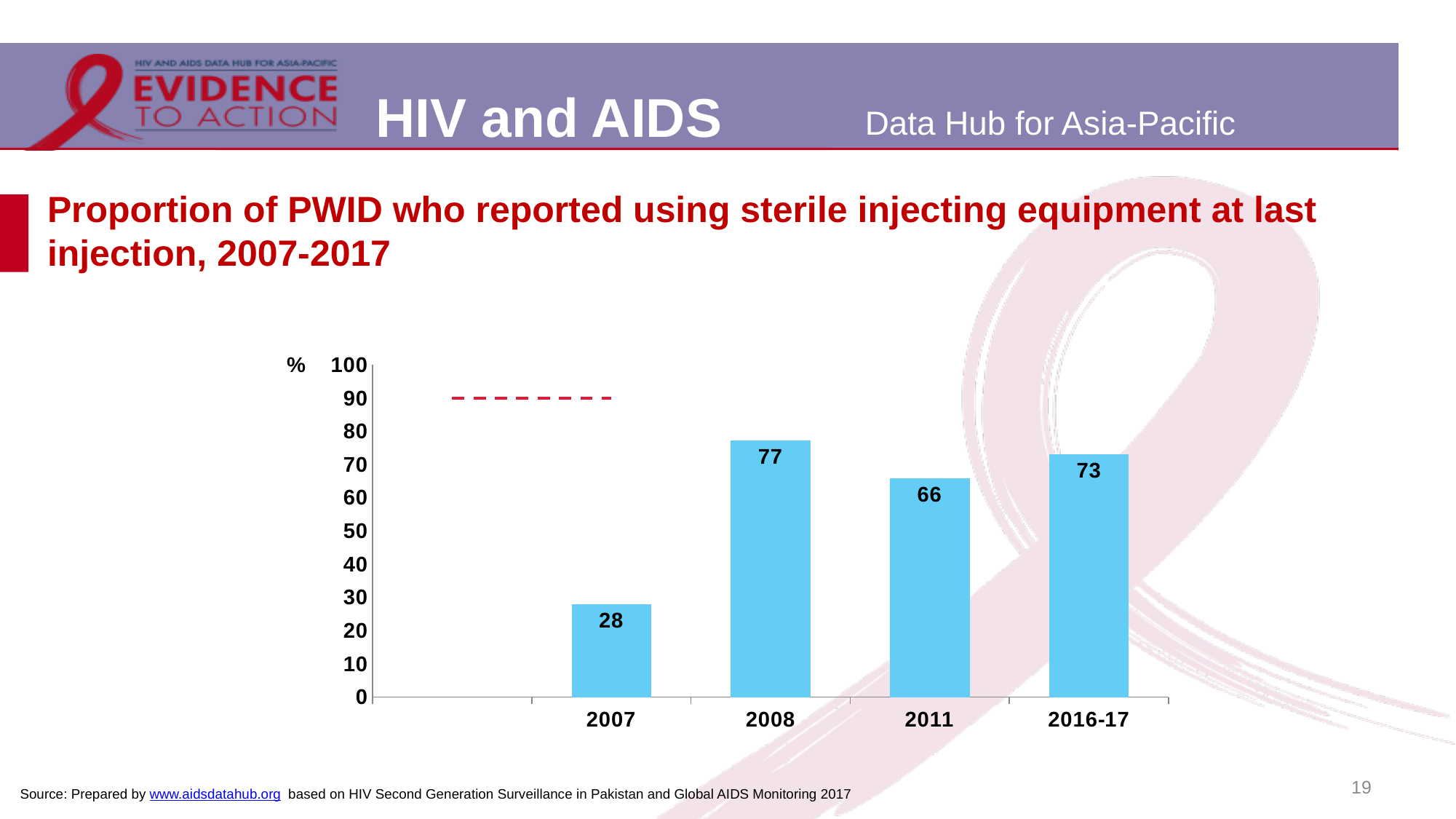
Is the value for 2008 greater or less than 90? less What is the value for 2016-17? 73 Which is larger, the value for 2011 or the value for 2016-17? 2016-17 What is the value for 2011? 66 What unit is shown on the y axis of the chart? % What is the value for 2007? 28 What kind of chart is shown on the slide? bar chart Which year has the highest value? 2008 What is the difference between the values for 2008 and 2007? 49 How many bars are shown in the chart? 4 Which year has the lowest value? 2007 What is the value for 2008? 77